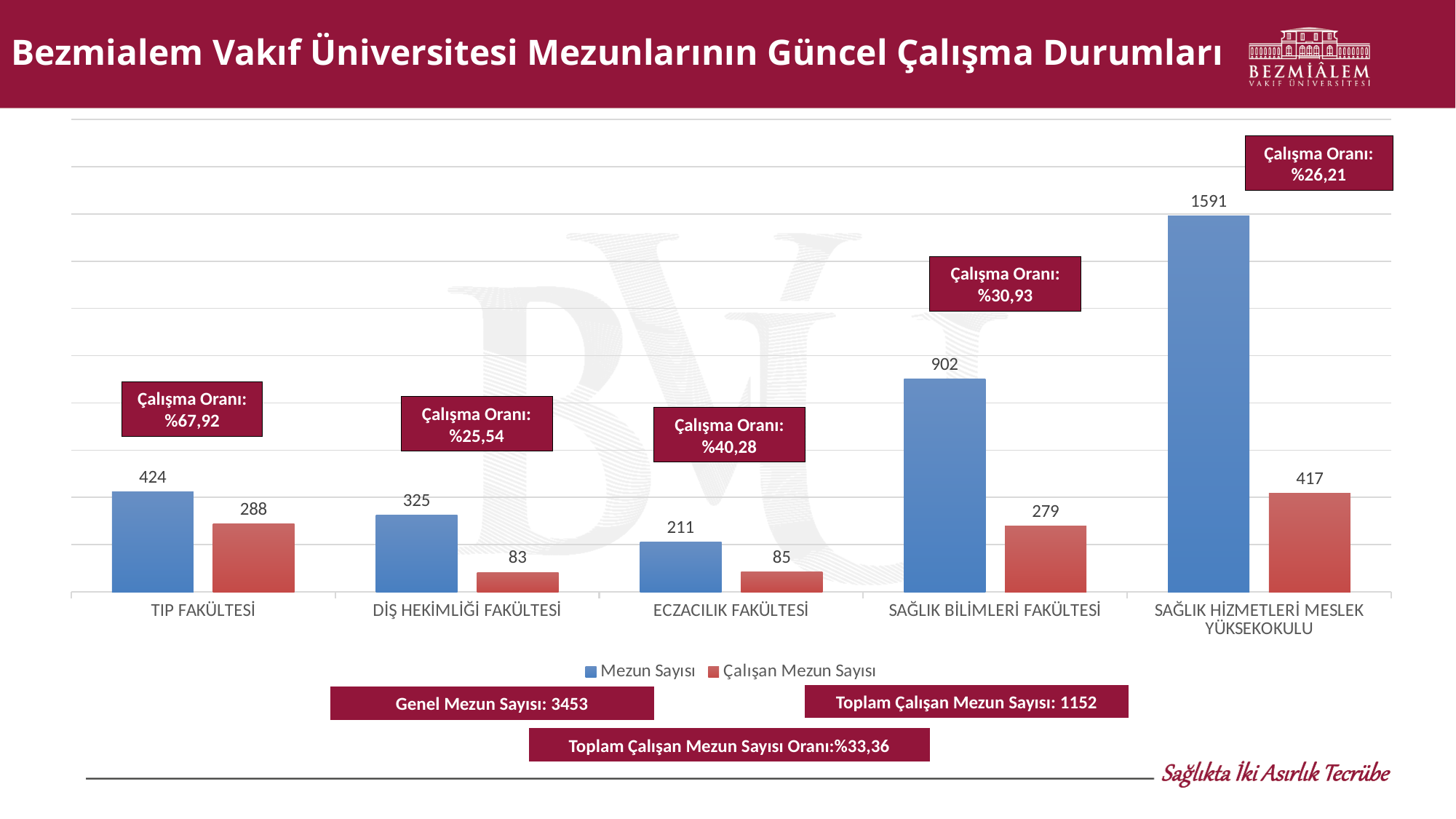
Which category has the highest Mezun Sayısı value? SAĞLIK HİZMETLERİ MESLEK YÜKSEKOKULU Which is larger: the Çalışan Mezun Sayısı value for TIP FAKÜLTESİ or for SAĞLIK BİLİMLERİ FAKÜLTESİ? TIP FAKÜLTESİ Which colour represents the Çalışan Mezun Sayısı series? Red What is the Mezun Sayısı value for TIP FAKÜLTESİ? 424 Which category has the lowest Mezun Sayısı value? ECZACILIK FAKÜLTESİ How many categories are shown on the x axis? 5 What is the Çalışma Oranı shown for ECZACILIK FAKÜLTESİ? %40,28 What is the Çalışan Mezun Sayısı value for DİŞ HEKİMLİĞİ FAKÜLTESİ? 83 What is the difference between the Mezun Sayısı and Çalışan Mezun Sayısı values for SAĞLIK HİZMETLERİ MESLEK YÜKSEKOKULU? 1174 What is the Çalışan Mezun Sayısı value for SAĞLIK BİLİMLERİ FAKÜLTESİ? 279 What kind of chart is shown on the slide? Bar chart How many series does the legend list? 2